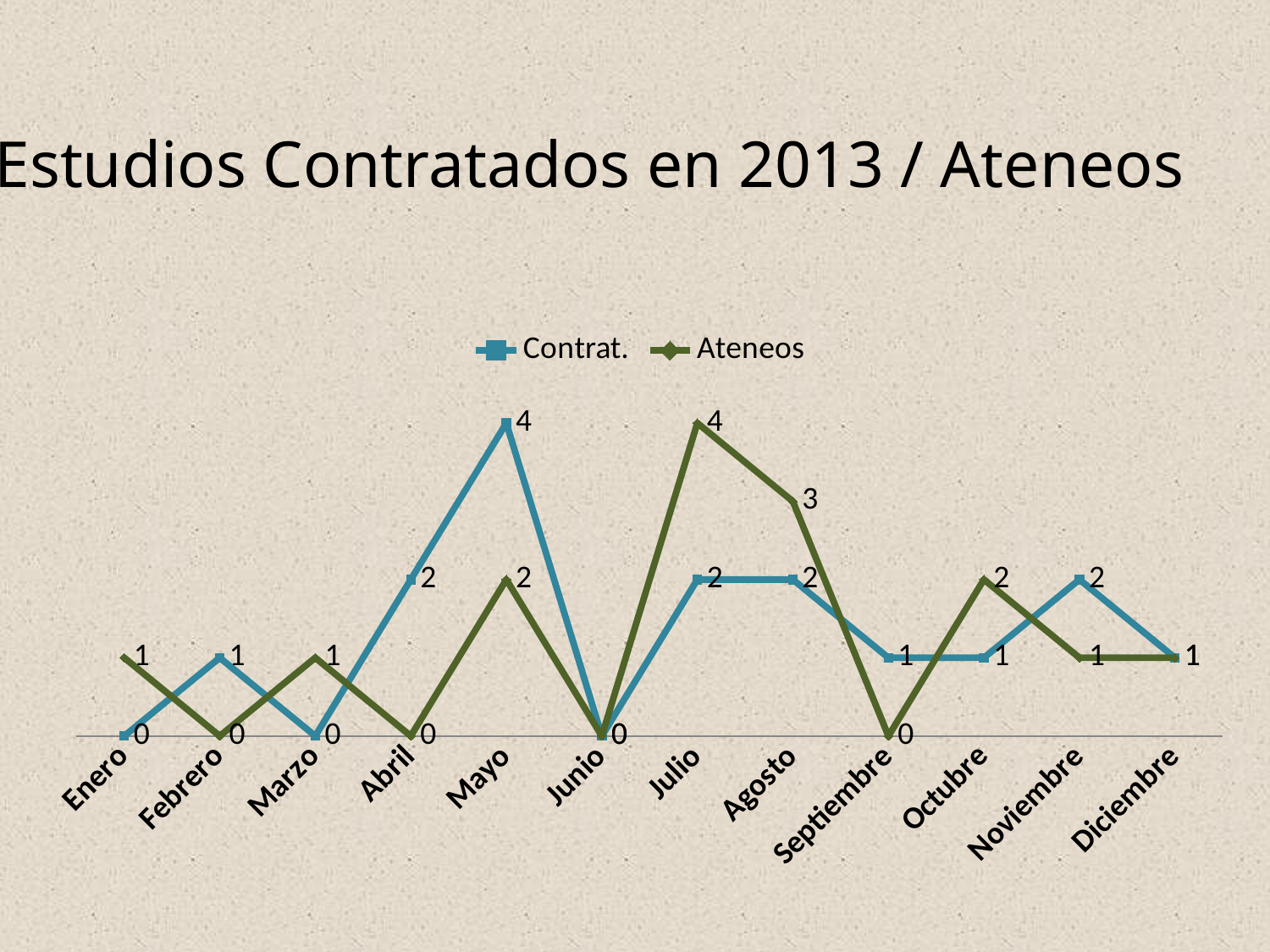
In which month does the Ateneos series reach its highest value? Julio What kind of chart is shown on the slide? Line chart What is the Ateneos value for Julio? 4 What is the Ateneos value for Agosto? 3 What is the difference between the Ateneos value and the Contrat. value in Julio? 2 In which month does the Contrat. series reach its highest value? Mayo How many months are shown on the x axis? 12 Which series has the larger value in Agosto, Contrat. or Ateneos? Ateneos How many series does the legend list? 2 What is the title of the slide? Estudios Contratados en 2013 / Ateneos What is the Contrat. value for Mayo? 4 What is the Contrat. value for Noviembre? 2